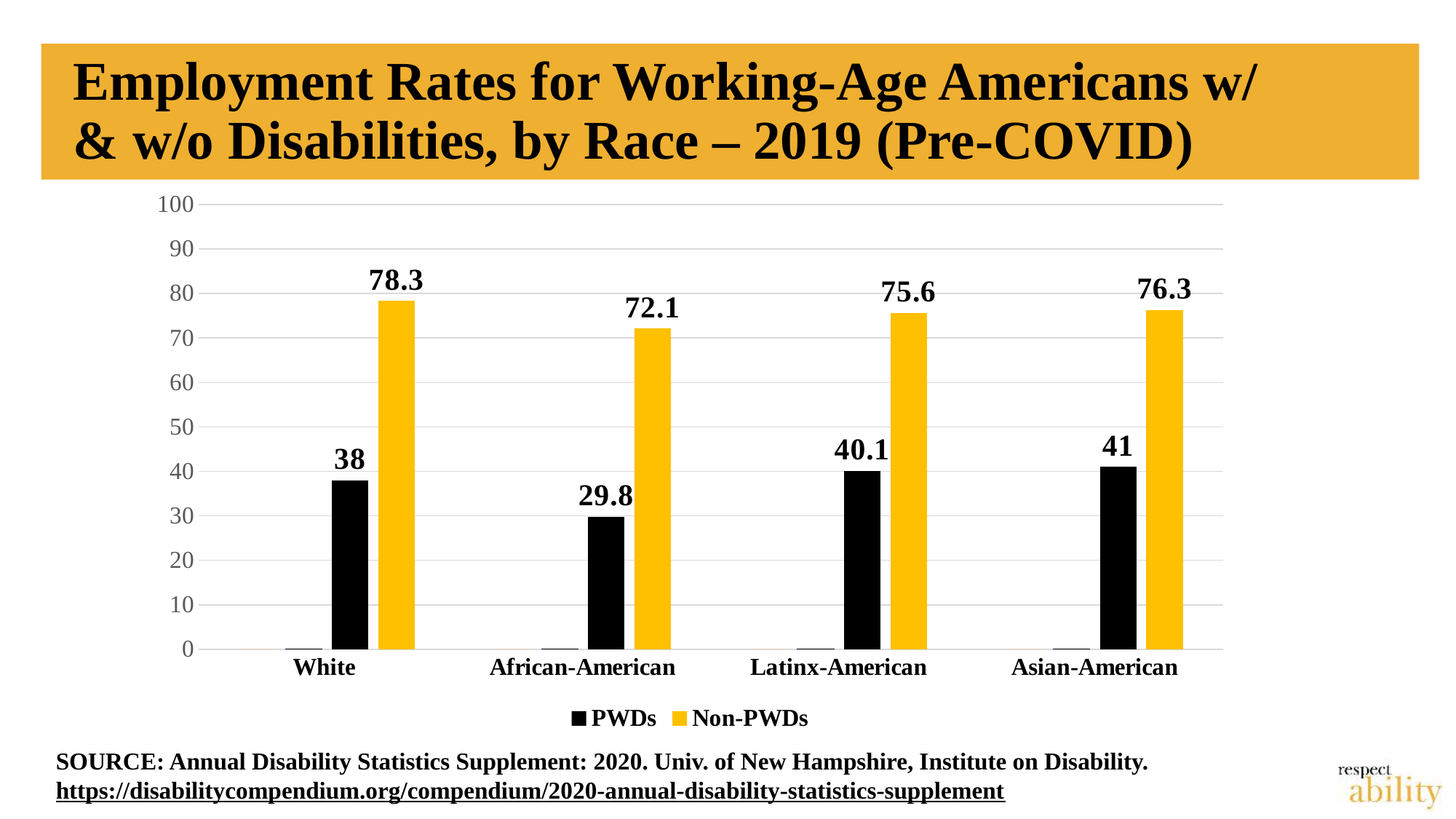
What is the employment rate for PWDs in the Latinx-American category? 40.1 What is the difference between the Non-PWDs and PWDs employment rates for the White category? 40.3 Which race category has the lowest PWDs employment rate? African-American How many race categories are shown on the x axis? 4 Which is larger: the PWDs employment rate for Asian-American or for Latinx-American? Asian-American What is the employment rate for Non-PWDs in the Asian-American category? 76.3 Which race category has the highest Non-PWDs employment rate? White How many series does the legend list? 2 Which colour represents the Non-PWDs series? Yellow What is the employment rate for Non-PWDs in the African-American category? 72.1 What is the employment rate for PWDs in the White category? 38 What kind of chart is shown on the slide? Bar chart